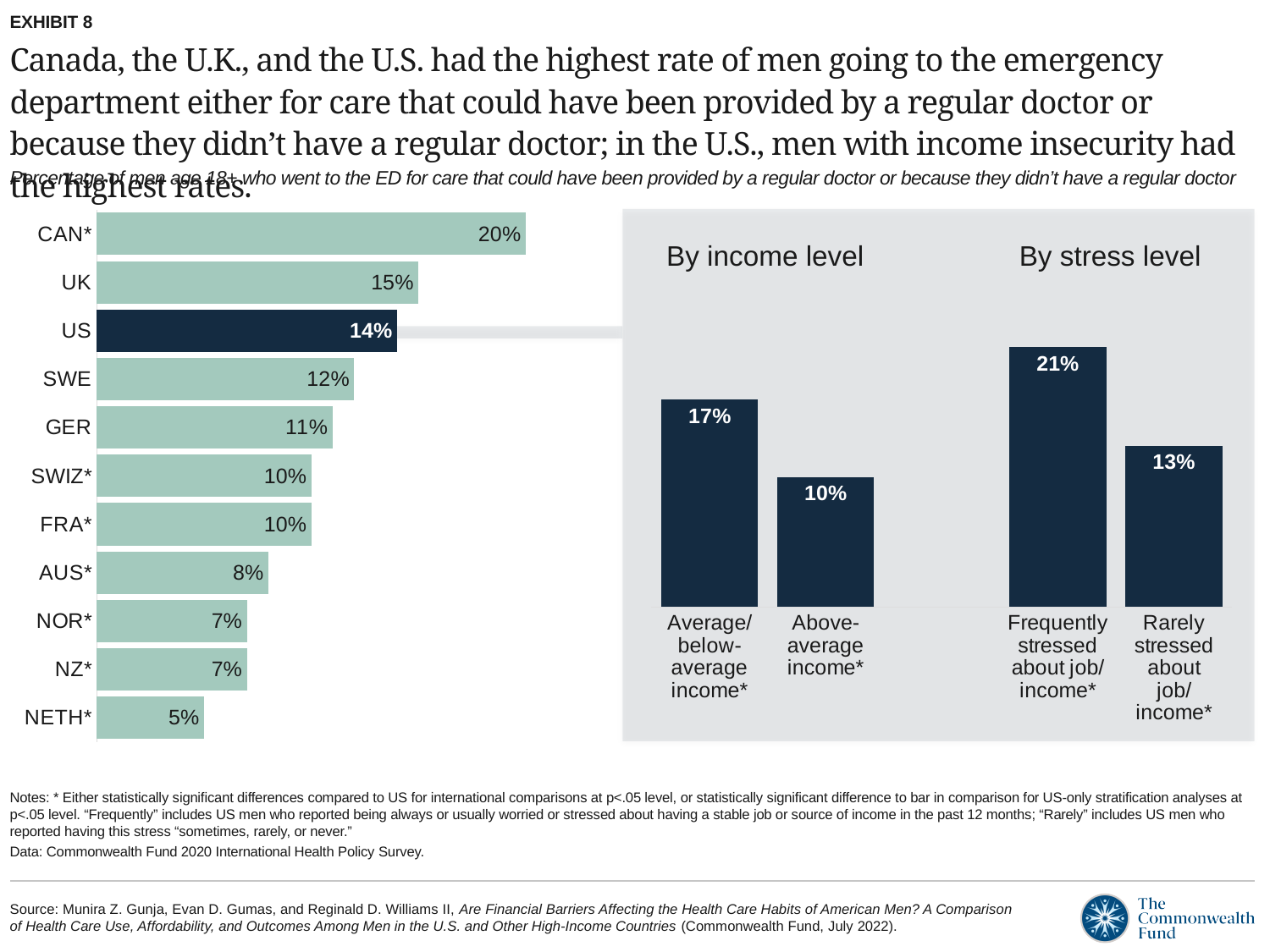
In the 'By stress level' chart on the right, what is the difference between frequently stressed and rarely stressed men? 8% In the 'By income level' chart on the right, what is the value for men with average/below-average income? 17% In the country bar chart on the left, which is larger, the value for SWE or the value for GER? SWE In the country bar chart on the left, what is the value for the UK? 15% How many countries are shown in the bar chart on the left? 11 In the country bar chart on the left, what is the value for the US? 14% In the country bar chart on the left, which country has the lowest value? NETH* In the country bar chart on the left, what is the difference between the values for CAN* and the US? 6% In the 'By stress level' chart on the right, what is the value for men frequently stressed about job/income? 21% What kind of chart is the country chart on the left? Bar chart In the country bar chart on the left, which country has the highest value? CAN* In the country bar chart on the left, which bar is shown in a darker colour than the others? US